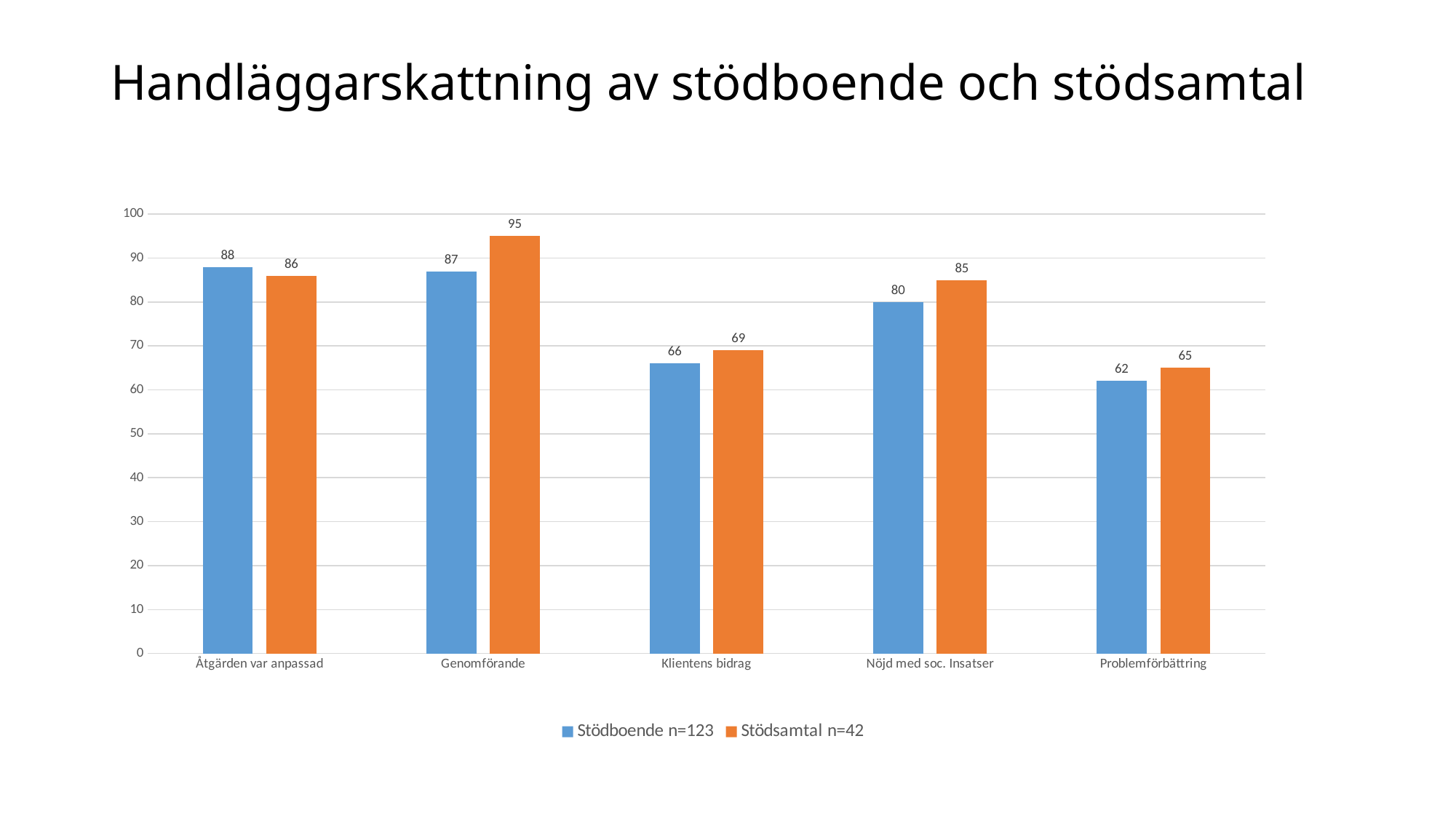
What is the difference between Stödsamtal n=42 and Stödboende n=123 for Genomförande? 8 Which category has the highest value for Stödsamtal n=42? Genomförande What is the title of the slide? Handläggarskattning av stödboende och stödsamtal Is the value for Stödboende n=123 for Klientens bidrag greater or less than 70? less What is the value for Stödboende n=123 for Problemförbättring? 62 How many series does the legend list? 2 What is the value for Stödsamtal n=42 for Genomförande? 95 What is the value for Stödboende n=123 for Åtgärden var anpassad? 88 What kind of chart is shown on the slide? bar chart Which category has the lowest value for Stödboende n=123? Problemförbättring For Nöjd med soc. Insatser, which series has the larger value, Stödboende n=123 or Stödsamtal n=42? Stödsamtal n=42 How many categories are shown on the x axis? 5